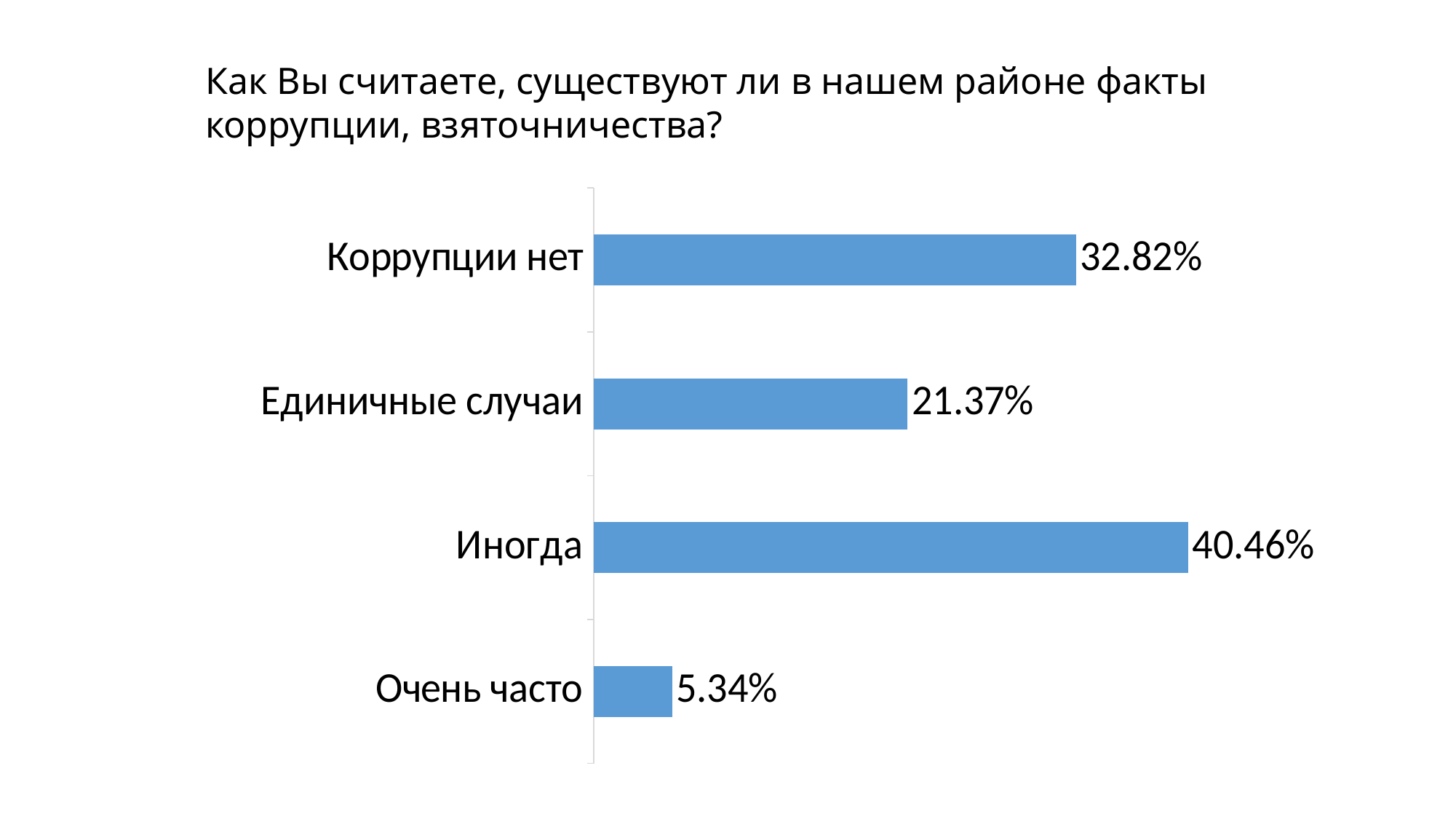
What is the difference between the values for "Единичные случаи" and "Очень часто"? 16.03% Which is larger: the value for "Коррупции нет" or the value for "Единичные случаи"? Коррупции нет What is the value for "Единичные случаи"? 21.37% Which category has the lowest value? Очень часто What is the value for "Очень часто"? 5.34% What is the value for "Коррупции нет"? 32.82% Which category has the highest value? Иногда How many categories are shown in the chart? 4 What is the title of the chart? Как Вы считаете, существуют ли в нашем районе факты коррупции, взяточничества? What is the value for "Иногда"? 40.46% What kind of chart is shown on the slide? Bar chart What is the difference between the values for "Иногда" and "Коррупции нет"? 7.64%